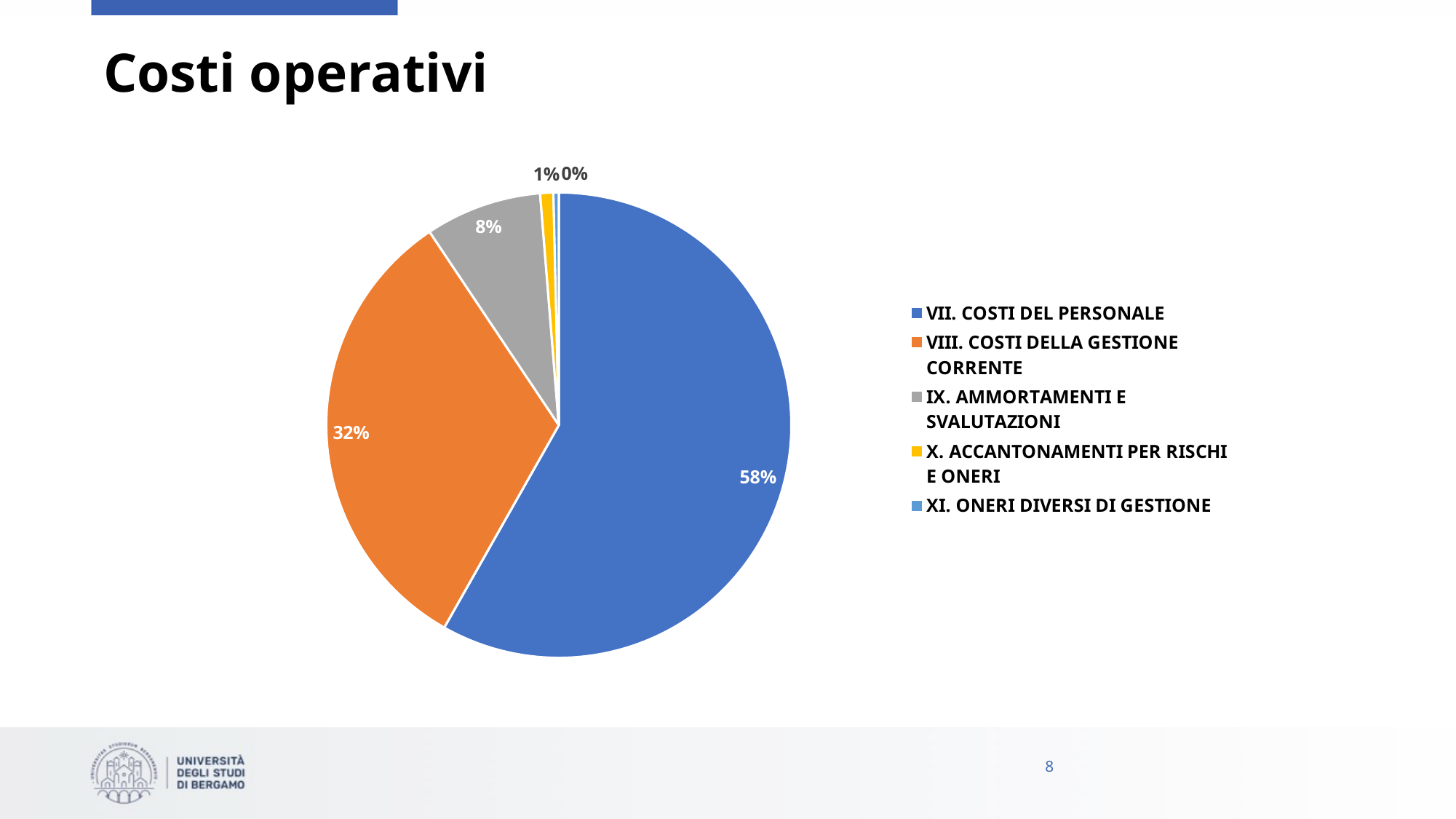
How many categories does the legend list? 5 Which category has the largest slice of the pie? VII. COSTI DEL PERSONALE What share of the pie does XI. ONERI DIVERSI DI GESTIONE represent? 0% What share of the pie does VII. COSTI DEL PERSONALE represent? 58% What kind of chart is shown on the slide? Pie chart What share of the pie does X. ACCANTONAMENTI PER RISCHI E ONERI represent? 1% What is the difference in percentage points between VII. COSTI DEL PERSONALE and VIII. COSTI DELLA GESTIONE CORRENTE? 26 percentage points What is the title of the slide containing the chart? Costi operativi Which is larger, the slice for VIII. COSTI DELLA GESTIONE CORRENTE or the slice for IX. AMMORTAMENTI E SVALUTAZIONI? VIII. COSTI DELLA GESTIONE CORRENTE Which category has the smallest slice of the pie? XI. ONERI DIVERSI DI GESTIONE